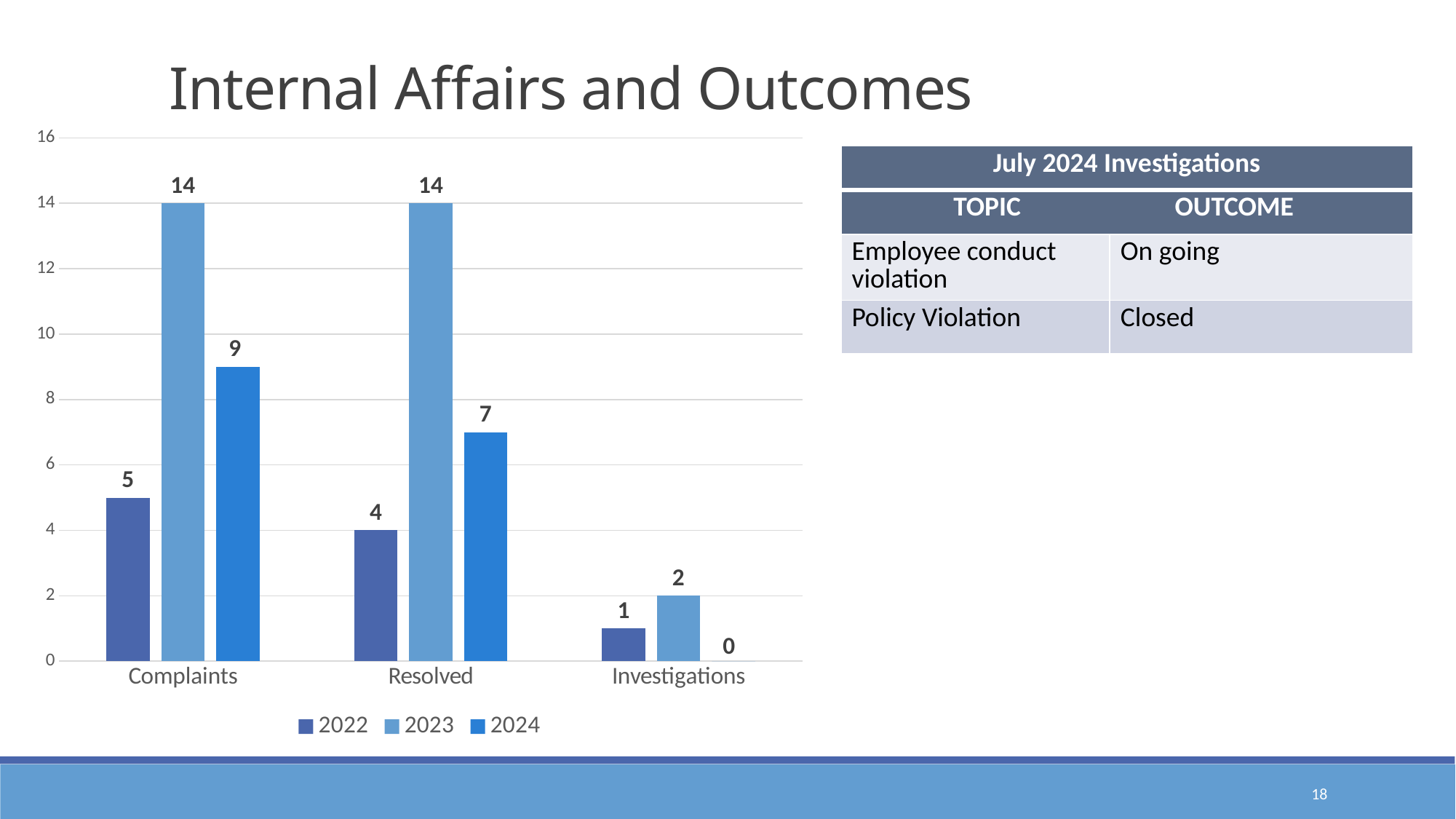
What is the difference between the 2023 and 2024 values for Complaints? 5 What is the value for Resolved in 2024? 7 Which is larger, the 2022 value for Complaints or the 2022 value for Resolved? Complaints What is the value for Complaints in 2023? 14 How many categories are shown on the x axis of the chart? 3 What is the value for Investigations in 2022? 1 What is the value for Investigations in 2024? 0 Which series is shown in the darkest blue in the legend? 2022 What kind of chart is shown on the slide? Bar chart Which category has the lowest value for 2023? Investigations What is the total of the three series values for Resolved? 25 How many series does the chart legend list? 3